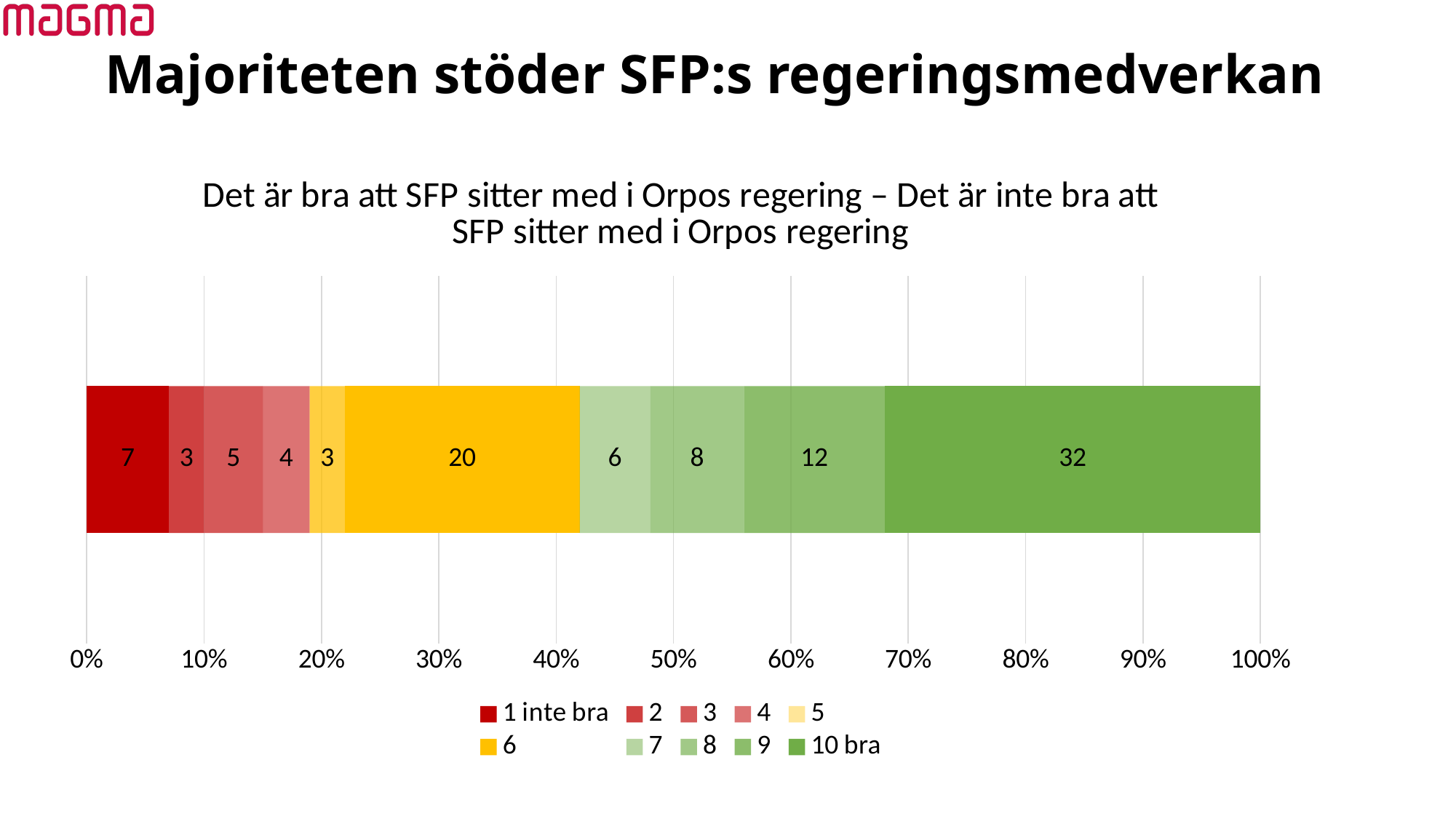
What value is shown for the segment labelled 9 in the legend? 12 What is the total of all segments in the stacked bar? 100 Which legend category has the largest segment in the bar? 10 bra Which is larger, the value for segment 8 or the value for segment 7? 8 How many series does the legend list? 10 What colour is the segment for "1 inte bra"? Dark red What kind of chart is shown on the slide? Stacked bar chart What value is shown for the segment "10 bra"? 32 What value is shown for the segment labelled 6 in the legend? 20 What is the difference between the values for "10 bra" and "1 inte bra"? 25 What is the difference between the values for segment 9 and segment 8? 4 What value is shown for the segment "1 inte bra"? 7